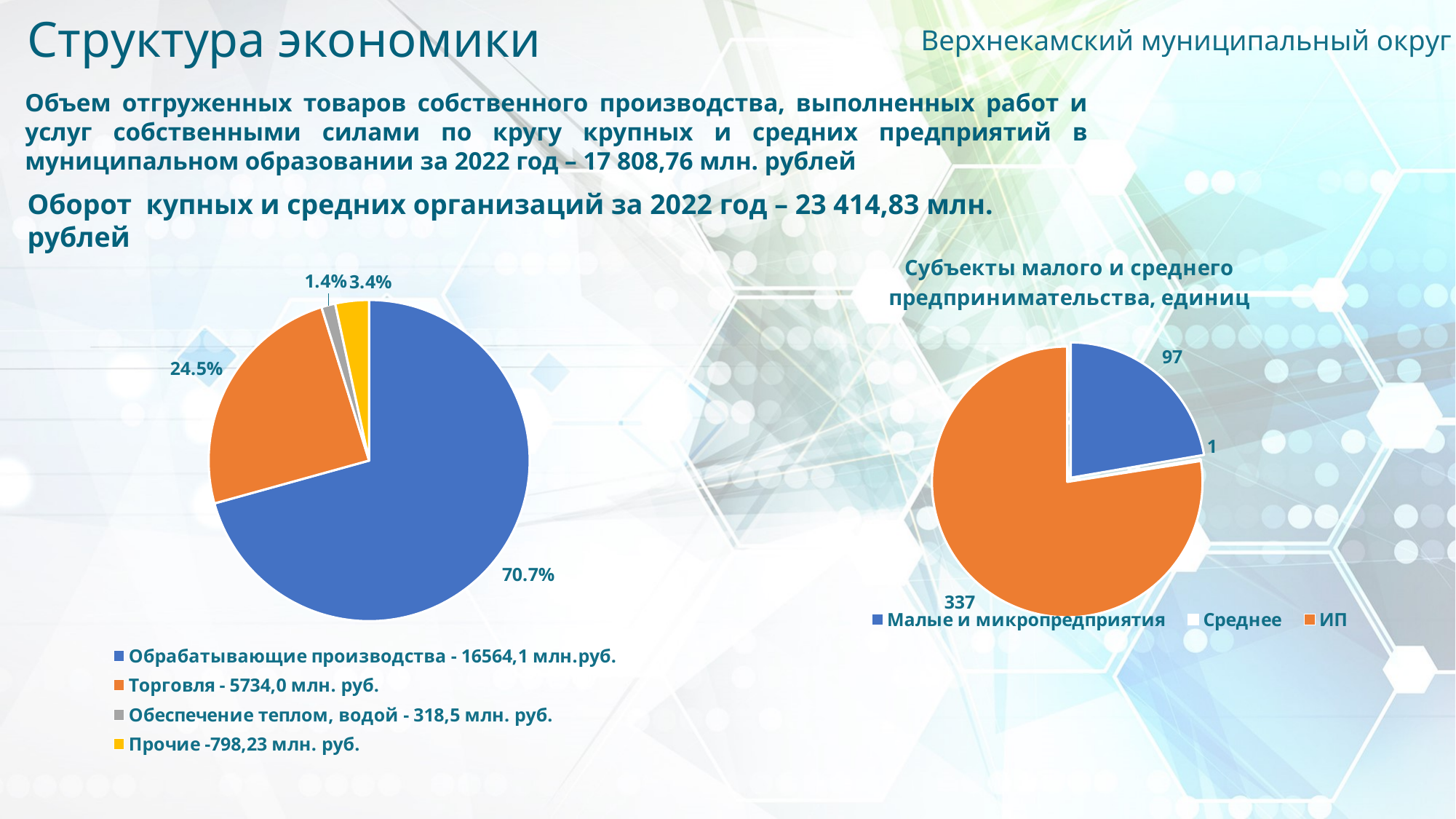
On the chart titled 'Субъекты малого и среднего предпринимательства, единиц', what is the value for Малые и микропредприятия? 97 On the left pie chart, which category has the largest share? Обрабатывающие производства On the left pie chart, which category has the smallest share? Обеспечение теплом, водой On the chart titled 'Субъекты малого и среднего предпринимательства, единиц', what is the value for ИП? 337 On the left pie chart, what share does Прочие have? 3.4% On the chart titled 'Субъекты малого и среднего предпринимательства, единиц', which category has the lowest value? Среднее On the left pie chart, what share does Торговля have? 24.5% On the left pie chart, how many categories are shown? 4 On the left pie chart, what is the difference in share between Обрабатывающие производства and Торговля? 46.2% On the left pie chart, what share does Обрабатывающие производства have? 70.7% What type of chart is the chart titled 'Субъекты малого и среднего предпринимательства, единиц'? Pie chart On the chart titled 'Субъекты малого и среднего предпринимательства, единиц', what is the difference between ИП and Малые и микропредприятия? 240